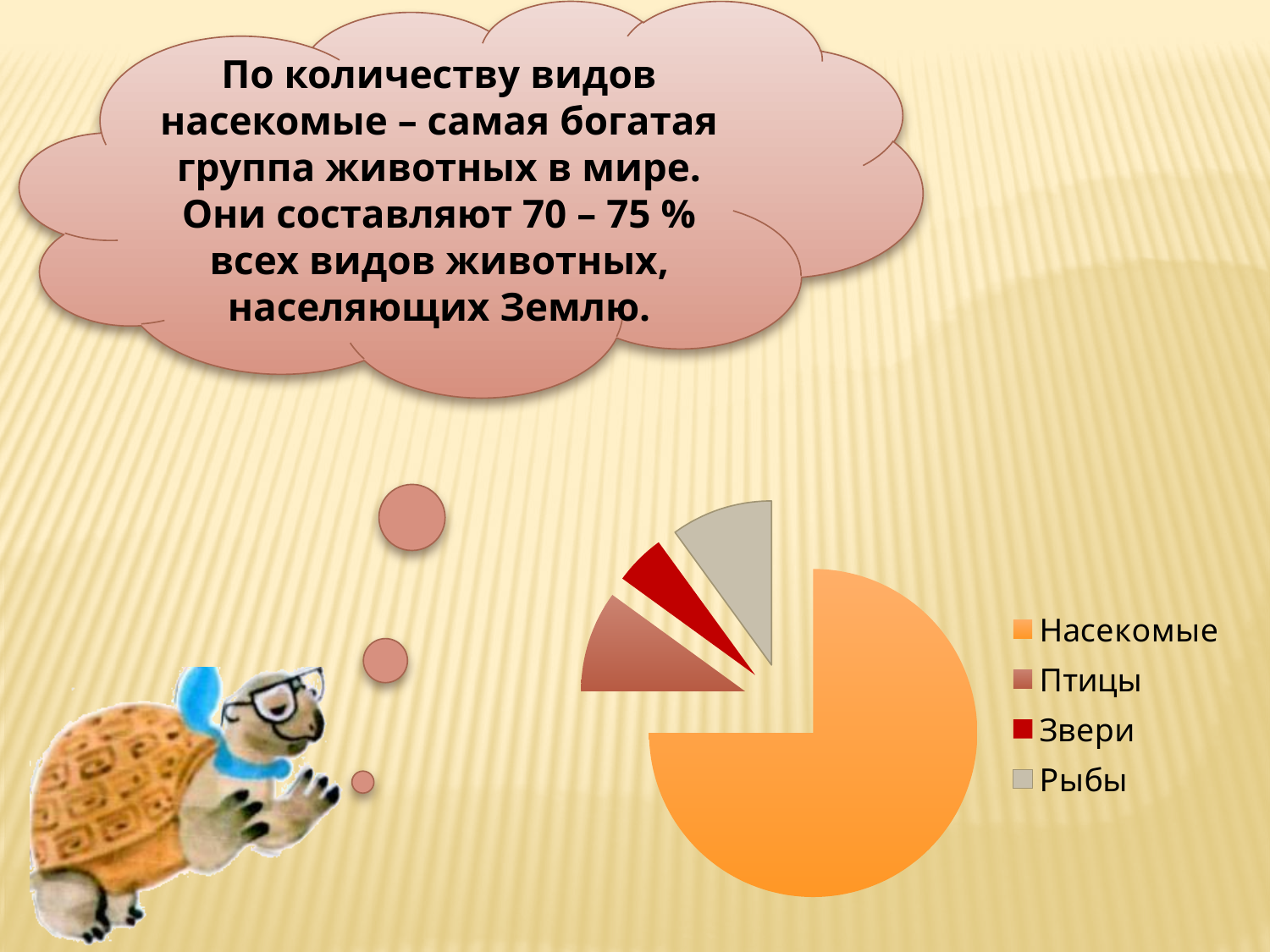
How many slices does the pie chart have? 4 How many entries does the legend of the pie chart list? 4 Which category has the largest slice in the pie chart? Насекомые What kind of chart is shown on the slide? pie chart What colour is the Насекомые slice in the pie chart? orange Which legend entry is shown in grey in the pie chart? Рыбы Which category has the smallest slice in the pie chart? Звери Which slice is larger in the pie chart, Птицы or Звери? Птицы Which slice is larger in the pie chart, Насекомые or Птицы? Насекомые